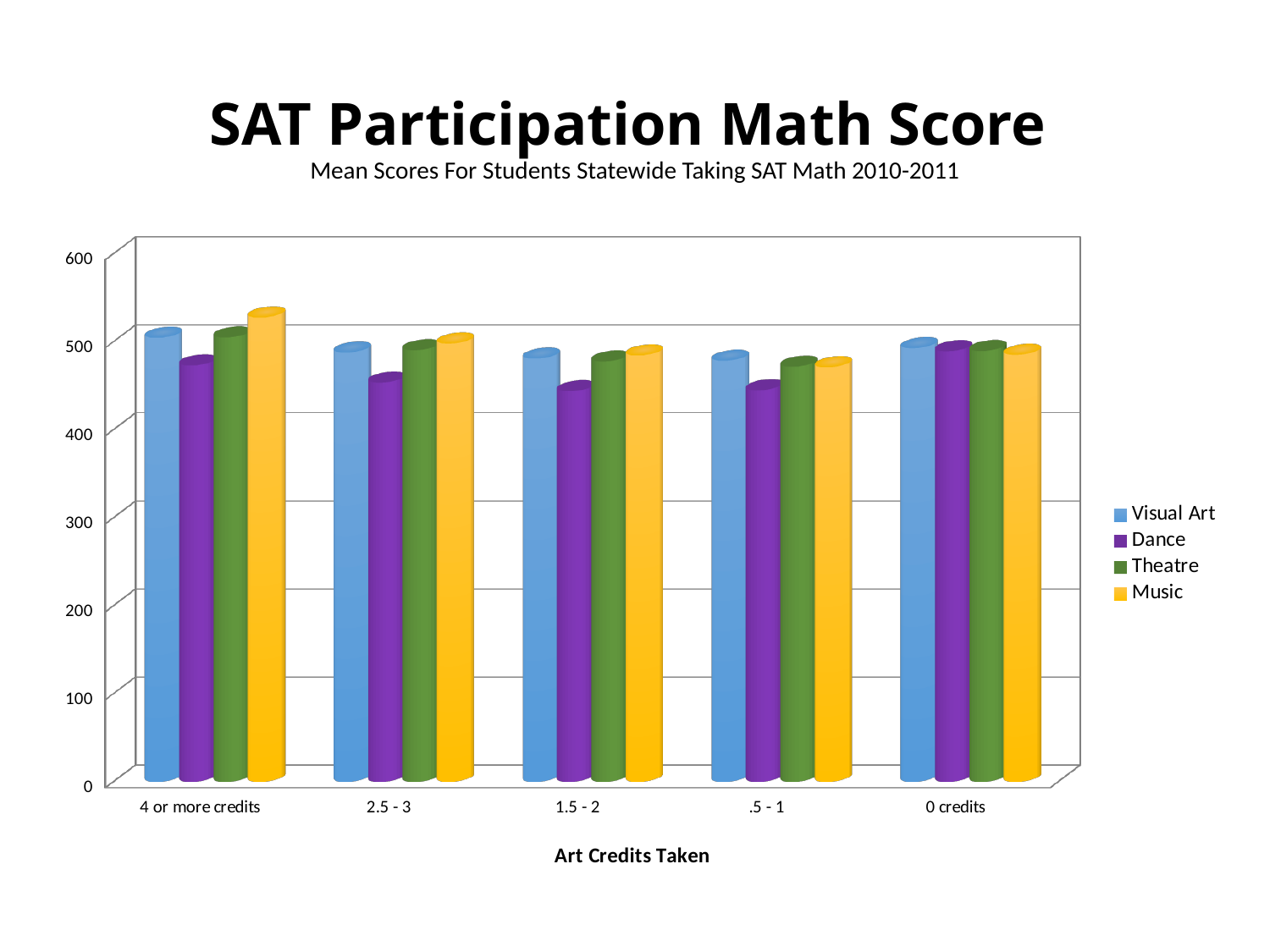
Is the Dance value for '4 or more credits' greater or less than 400? greater Which series has the lowest bar in the '4 or more credits' category? Dance What is the title of the x axis? Art Credits Taken How many art-credit categories are shown on the x axis? 5 Is the Dance value for '1.5 - 2' credits greater or less than 500? less How many series does the legend list? 4 In the '4 or more credits' category, which is larger: the Music bar or the Dance bar? Music Is the Music value for '4 or more credits' greater or less than 500? greater Which series has the highest bar in the '4 or more credits' category? Music Which series has the lowest bar in the '1.5 - 2' category? Dance Which legend entry is shown in yellow? Music What kind of chart is shown on the slide? bar chart